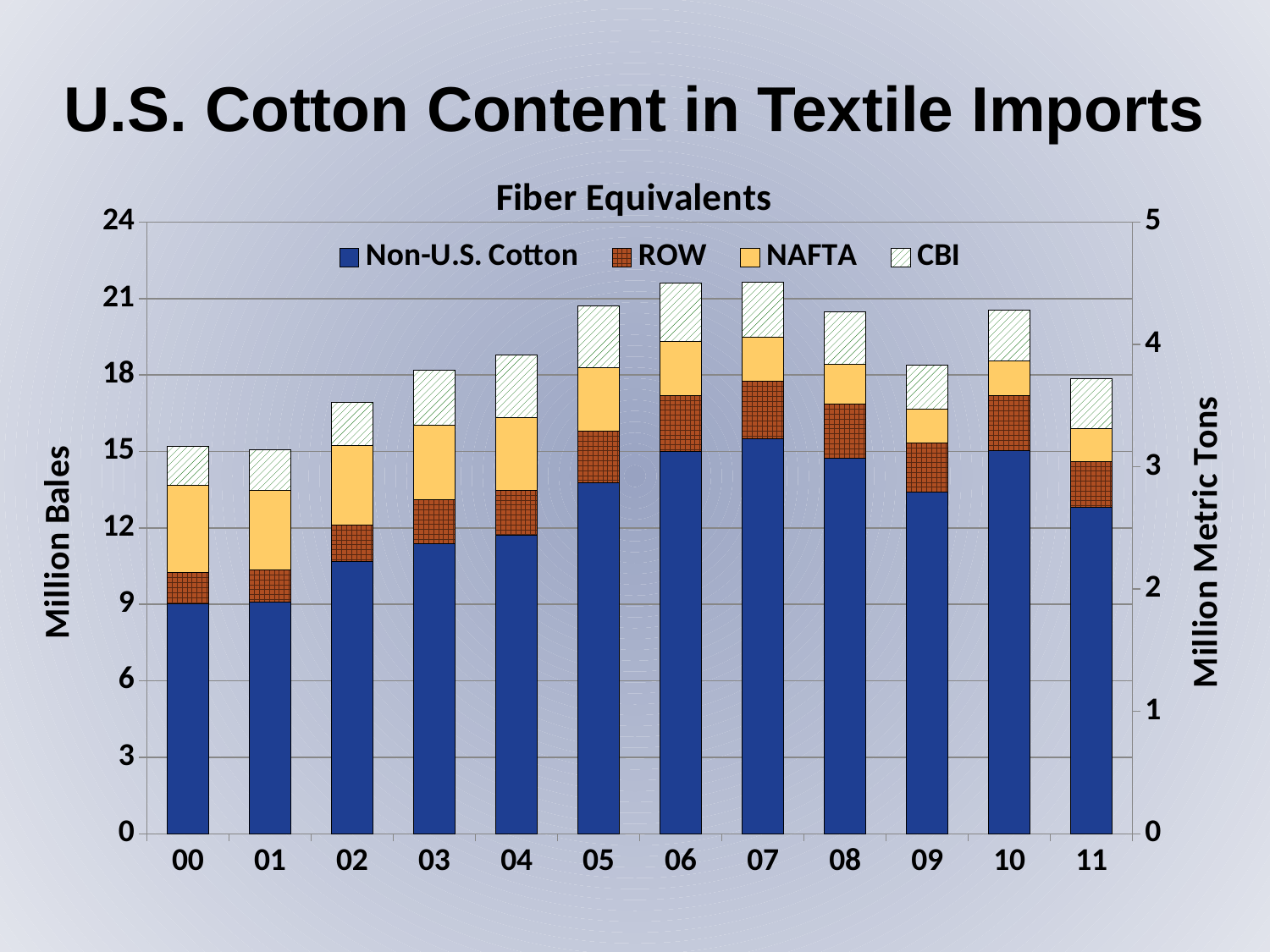
Is the Non-U.S. Cotton value for 05 greater or less than 12 million bales? greater Which year has the larger total stacked bar, 01 or 06? 06 Do the total stacked bars rise or fall from 00 to 07? rise What kind of chart is shown on the slide? Stacked bar chart What is the title printed above the chart's plot area? Fiber Equivalents Is the total stacked bar for 06 greater or less than 21 million bales? greater How many series does the chart's legend list? 4 How many years are shown along the x axis of the chart? 12 Is the total stacked bar for 02 greater or less than 18 million bales? less What is the label of the left vertical axis? Million Bales Which year has the larger Non-U.S. Cotton value, 02 or 05? 05